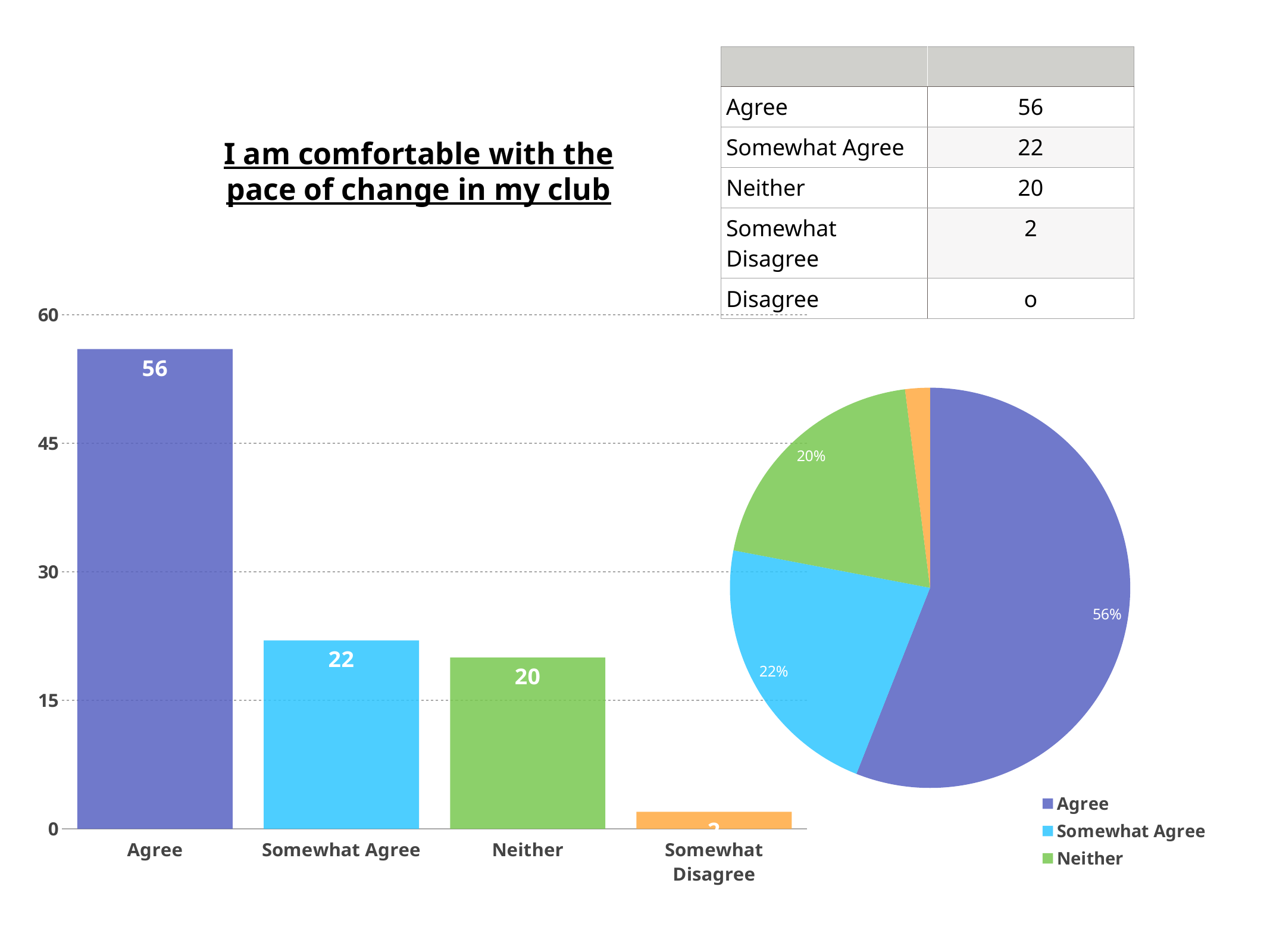
In the bar chart, what is the difference between the values for Agree and Somewhat Agree? 34 In the bar chart, which category has the highest value? Agree In the bar chart, which is larger, the value for Somewhat Agree or the value for Neither? Somewhat Agree In the bar chart, what is the value for Neither? 20 How many entries does the legend of the pie chart list? 3 How many categories are shown in the bar chart? 4 In the bar chart, is the value for Somewhat Disagree greater or less than 15? less In the bar chart, what is the value for Agree? 56 What kind of chart is the chart on the left of the slide? bar chart In the pie chart, what share does the Somewhat Agree slice have? 22% In the bar chart, what is the value for Somewhat Agree? 22 In the bar chart, which category has the lowest value? Somewhat Disagree